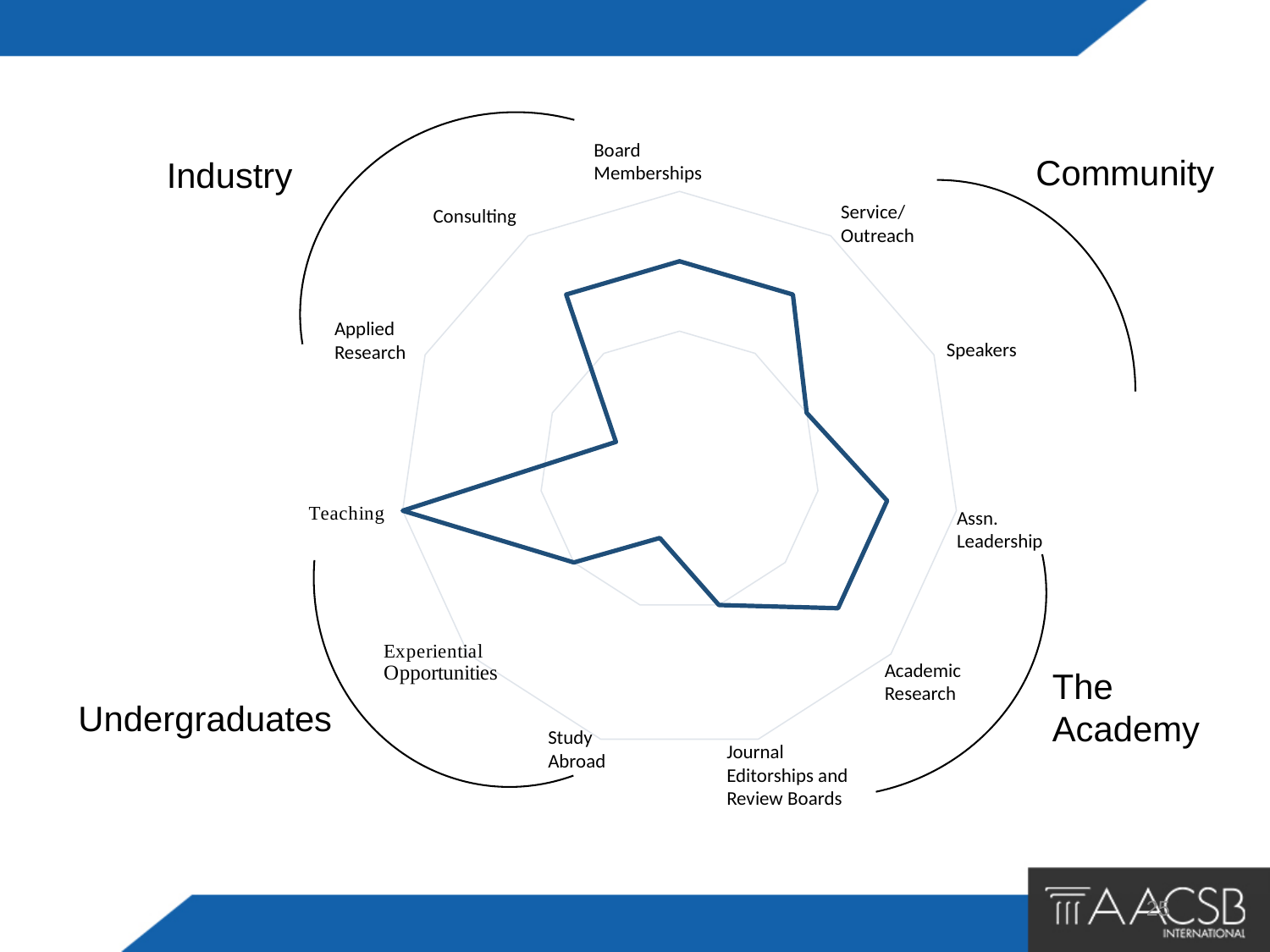
How many categories (axes) does the radar chart have? 11 Which is larger on the radar chart, the value for Teaching or the value for Board Memberships? Teaching Which is larger on the radar chart, the value for Service/Outreach or the value for Experiential Opportunities? Service/Outreach Which group label appears at the top right of the radar chart? Community Which category has the highest value on the radar chart? Teaching How many data series are plotted on the radar chart? 1 What are the four group labels placed around the outside of the radar chart? Industry, Community, The Academy, Undergraduates Which is larger on the radar chart, the value for Assn. Leadership or the value for Study Abroad? Assn. Leadership What kind of chart is shown on the slide? Radar chart